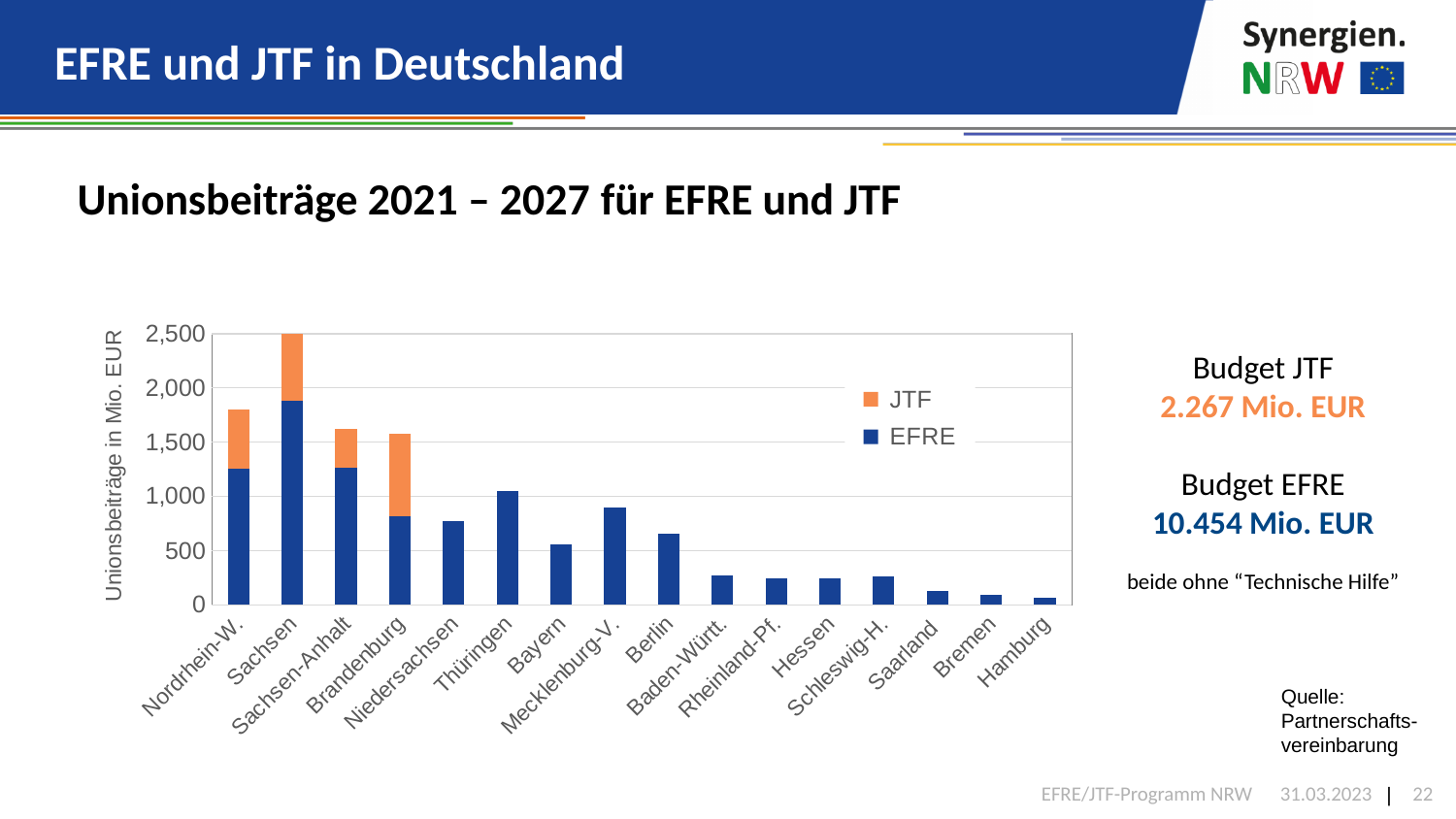
Is the value for Niedersachsen greater or less than 1,000? less What kind of chart is shown on the slide? Stacked bar chart Is the value for Berlin greater or less than 500? greater Which federal state has the lowest total bar in the chart? Hamburg Which has the larger total bar, Nordrhein-W. or Brandenburg? Nordrhein-W. Is the value for Hamburg greater or less than 500? less Do the bar totals generally rise or fall from left to right along the x axis? fall How many series does the chart legend list? 2 Which federal state has the highest total bar in the chart? Sachsen How many federal states (categories) are shown on the x axis of the chart? 16 How many federal states have a JTF (orange) segment in their bar? 4